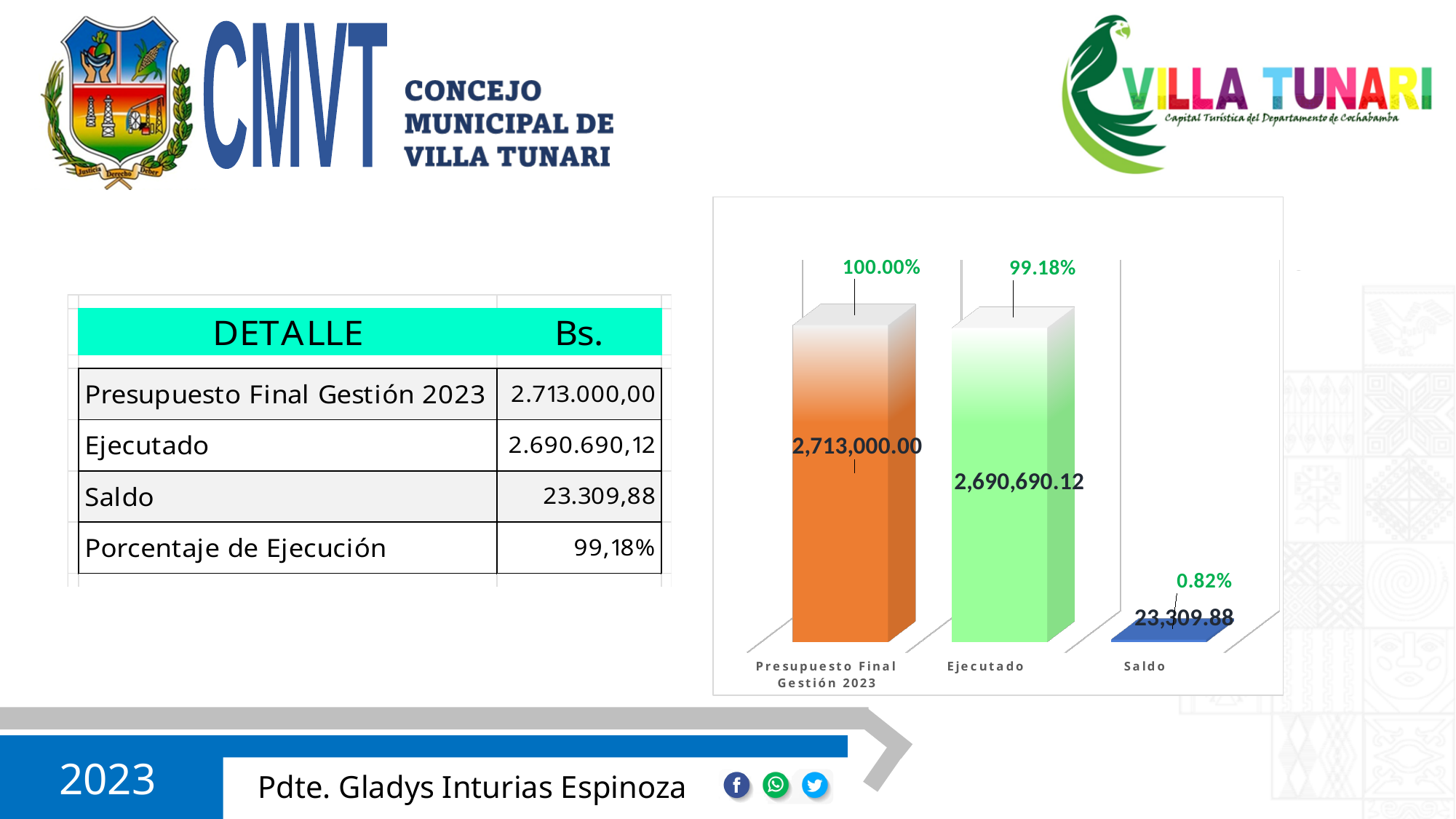
What kind of chart is shown on the slide? Bar chart Which is larger, the value for Ejecutado or the value for Saldo? Ejecutado How many categories are plotted in the chart? 3 What is the difference between the percentage labels for Presupuesto Final Gestión 2023 and Ejecutado? 0.82% Which category has the highest value in the chart? Presupuesto Final Gestión 2023 What value is shown for Ejecutado in the chart? 2,690,690.12 Do the values rise or fall from left to right across the categories? Fall What value is shown for Saldo in the chart? 23,309.88 What value is shown for Presupuesto Final Gestión 2023 in the chart? 2,713,000.00 What percentage is labelled above the Saldo bar? 0.82% What percentage is labelled above the Ejecutado bar? 99.18% Which category has the lowest value in the chart? Saldo